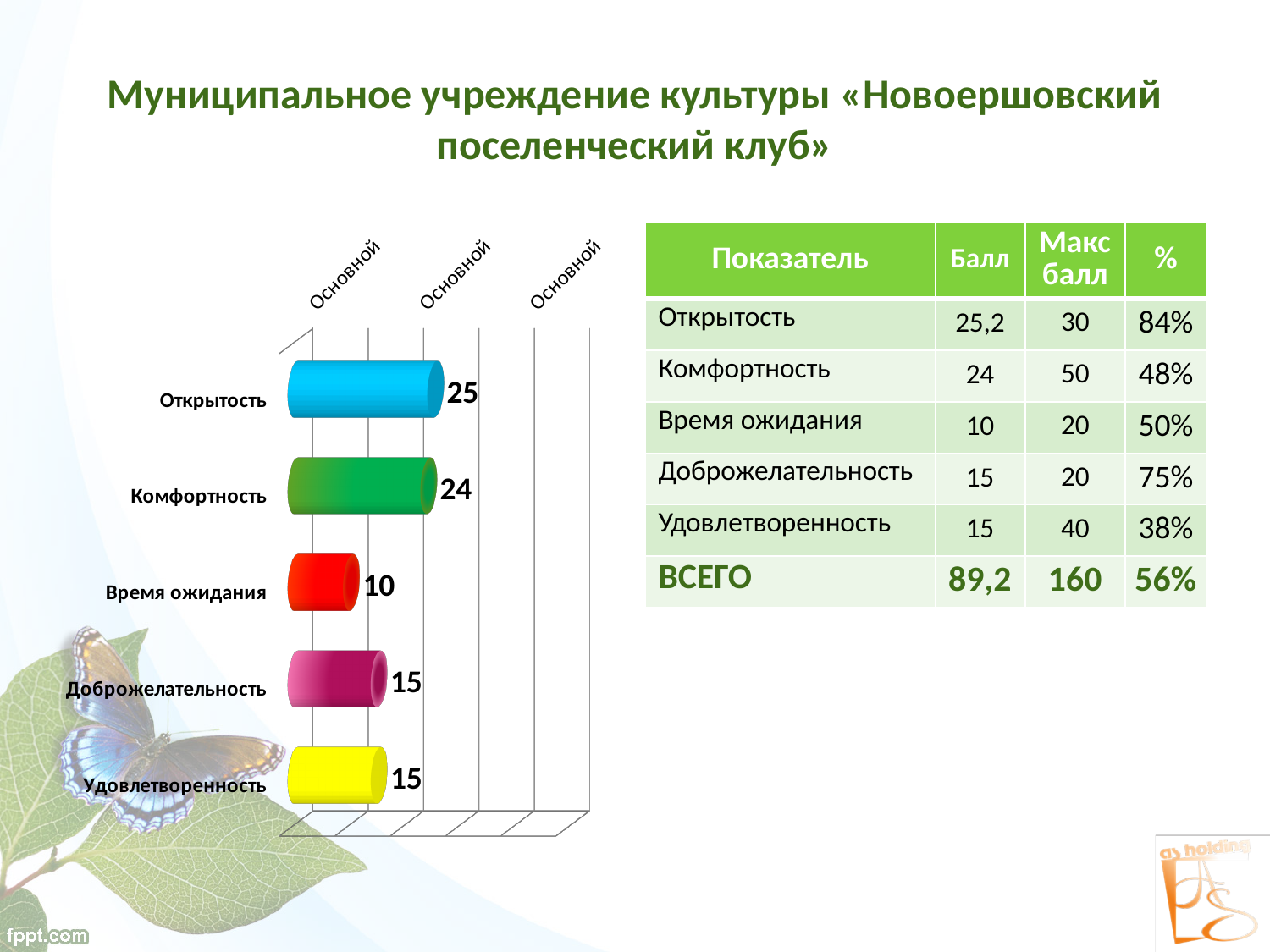
Which category has the lowest value in the bar chart? Время ожидания What is the difference between the values for Комфортность and Доброжелательность in the bar chart? 9 Which category has the highest value in the bar chart? Открытость Which is larger in the bar chart, the value for Комфортность or the value for Удовлетворенность? Комфортность What colour is the bar for Удовлетворенность in the chart? Yellow What is the difference between the values for Открытость and Время ожидания in the bar chart? 15 What kind of chart is shown on the slide? Bar chart How many categories are shown in the bar chart? 5 What is the value shown for Комфортность in the bar chart? 24 What is the value shown for Доброжелательность in the bar chart? 15 What is the value shown for Открытость in the bar chart? 25 What is the value shown for Время ожидания in the bar chart? 10